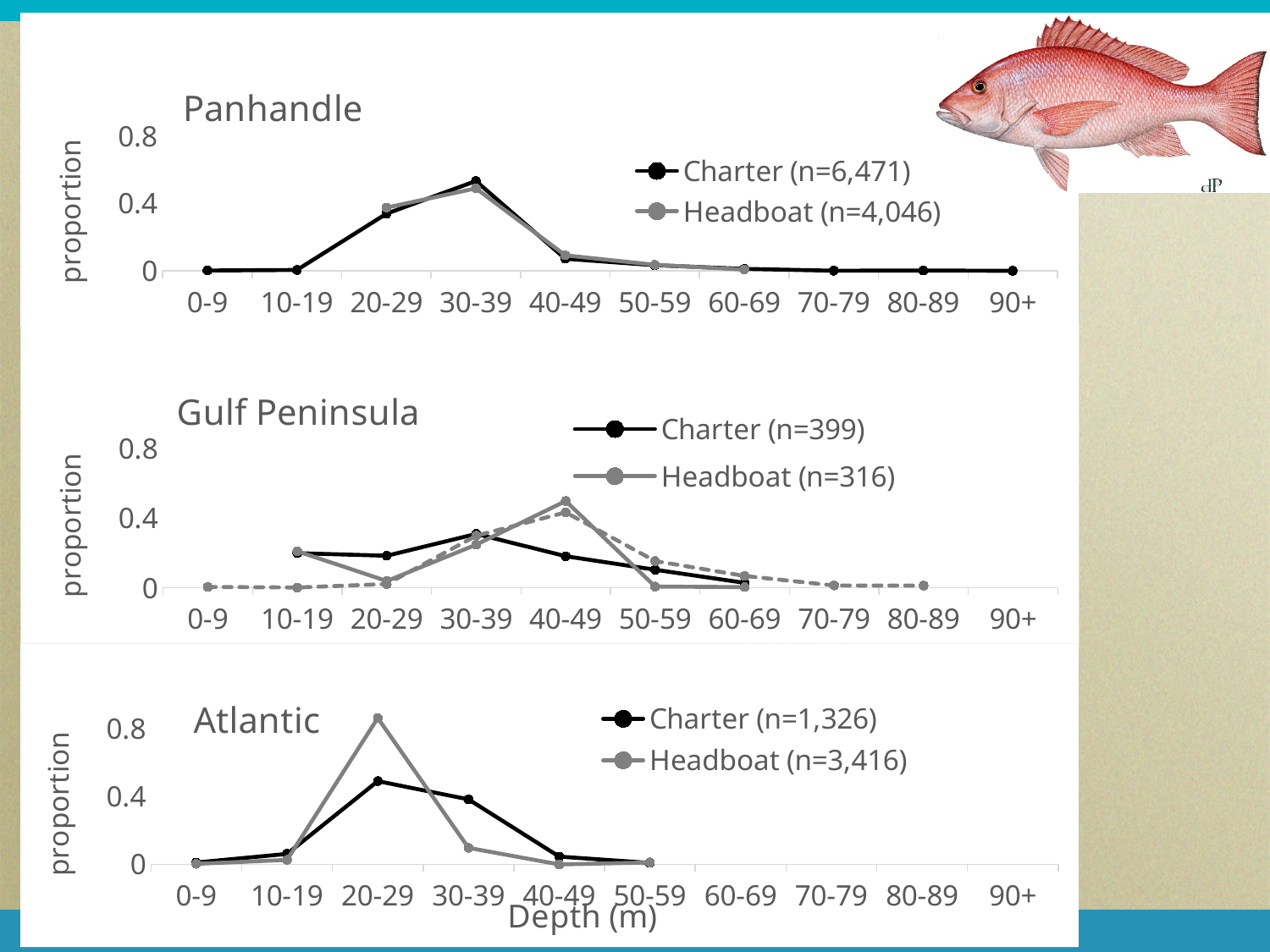
How many series does the legend of the Atlantic chart list? 2 In the Panhandle chart, is the Charter proportion for 40-49 greater or less than 0.4? less How many depth categories are shown on the x axis of the Panhandle chart? 10 In the Panhandle chart, which depth category has the highest Charter proportion? 30-39 In the Atlantic chart, which series has the larger proportion at 30-39, Charter or Headboat? Charter In the Atlantic chart, is the Headboat proportion for 20-29 greater or less than 0.8? greater In the Panhandle chart, is the Charter proportion for 30-39 greater or less than 0.4? greater In the Atlantic chart, which depth category has the highest Headboat proportion? 20-29 In the Gulf Peninsula chart, which series has the larger proportion at 40-49, Charter or Headboat? Headboat In the Gulf Peninsula chart, which depth category has the highest Headboat proportion? 40-49 What kind of chart is the Panhandle chart? line chart